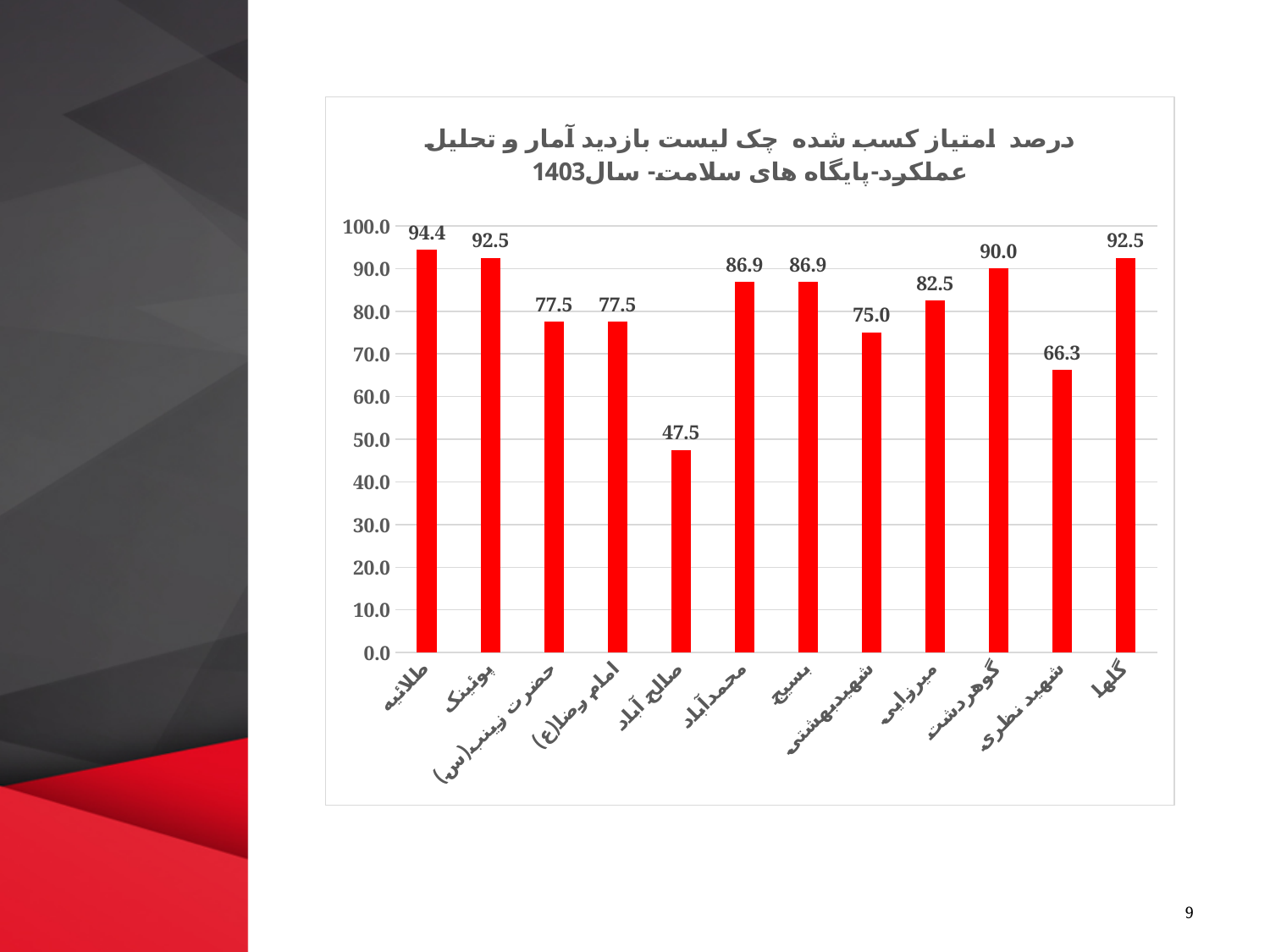
How many categories are shown on the x axis? 12 What type of chart is shown on the slide? bar chart What is the difference between the values for طلائیه and صالح آباد? 46.9 Which is larger, the value for میرزایی or the value for شهیدبهشتی? میرزایی What colour are the bars in the chart? red Which category has the lowest value? صالح آباد What is the difference between the values for گلها and شهید نظری? 26.2 What is the value for طلائیه? 94.4 What is the value for گوهردشت? 90.0 What is the value for صالح آباد? 47.5 Which category has the highest value? طلائیه What is the value for شهید نظری? 66.3